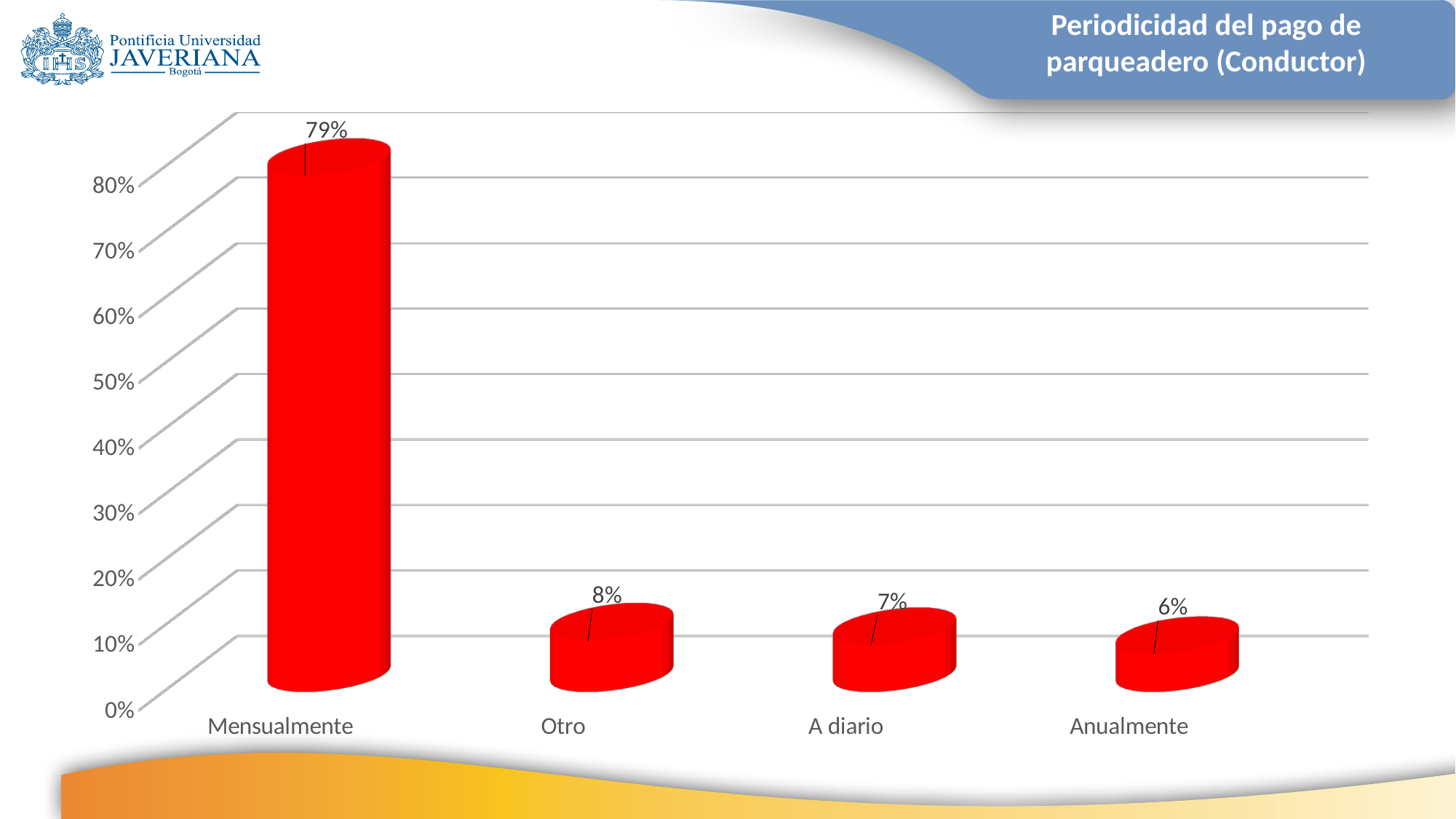
What kind of chart is shown on the slide? Bar chart Which category has the highest value? Mensualmente What is the difference between the values for Mensualmente and Otro? 71% What is the value for Otro? 8% What is the value for A diario? 7% Which is larger, the value for Otro or the value for A diario? Otro What is the title of the chart? Periodicidad del pago de parqueadero (Conductor) What is the difference between the values for Otro and Anualmente? 2% What is the value for Anualmente? 6% What is the value for Mensualmente? 79% How many categories are shown on the x axis? 4 Which category has the lowest value? Anualmente